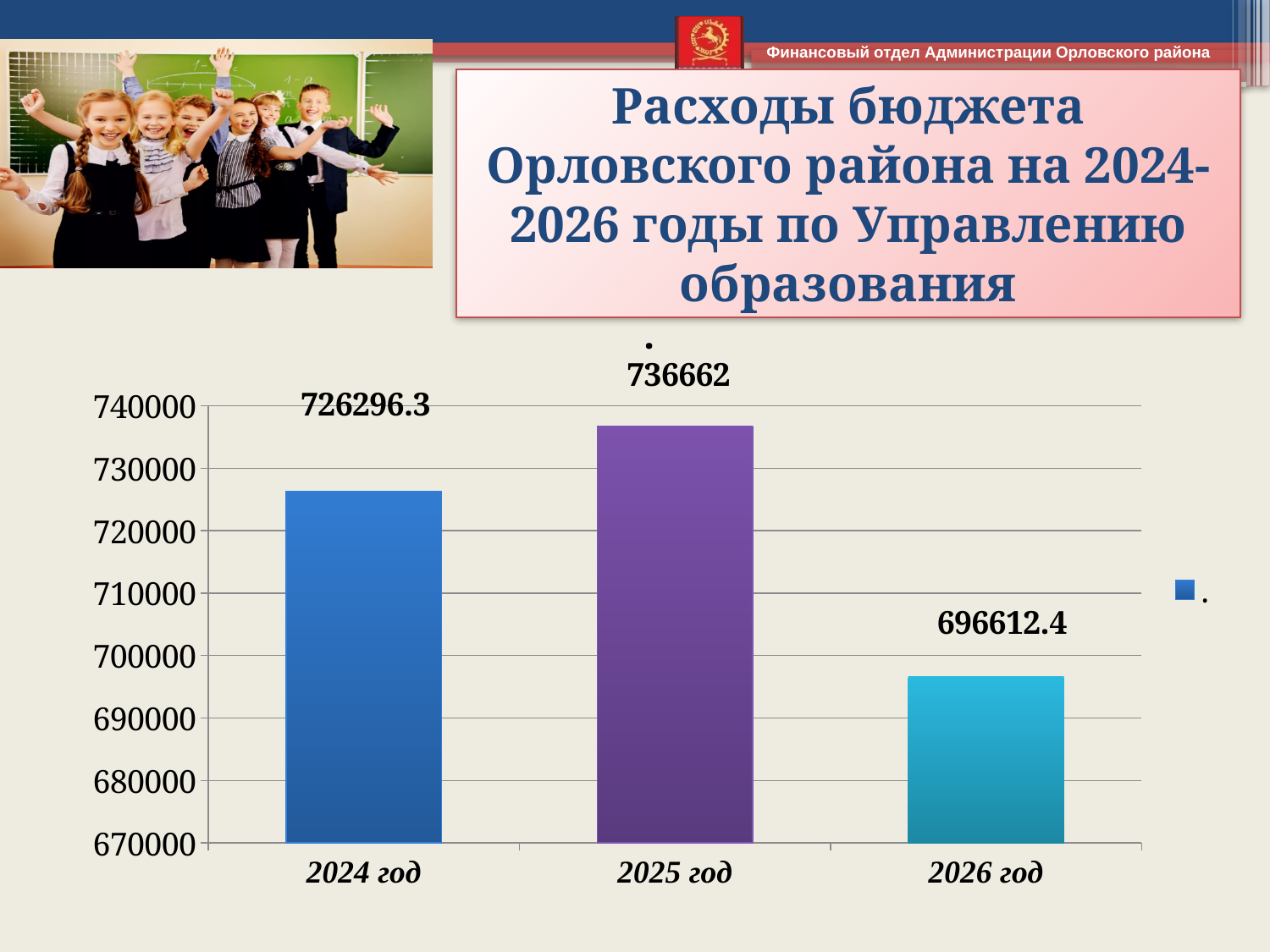
What is the difference between the values for 2025 год and 2024 год? 10365.7 What is the value for 2026 год? 696612.4 Which year has the lowest value? 2026 год How many years are shown on the x axis? 3 What is the difference between the values for 2024 год and 2026 год? 29683.9 Is the value for 2026 год greater or less than 700000? less What is the value for 2025 год? 736662 What is the value for 2024 год? 726296.3 Does the value rise or fall from 2025 год to 2026 год? fall Which is larger, the value for 2024 год or the value for 2026 год? 2024 год Which year has the highest value? 2025 год What kind of chart is shown on the slide? bar chart